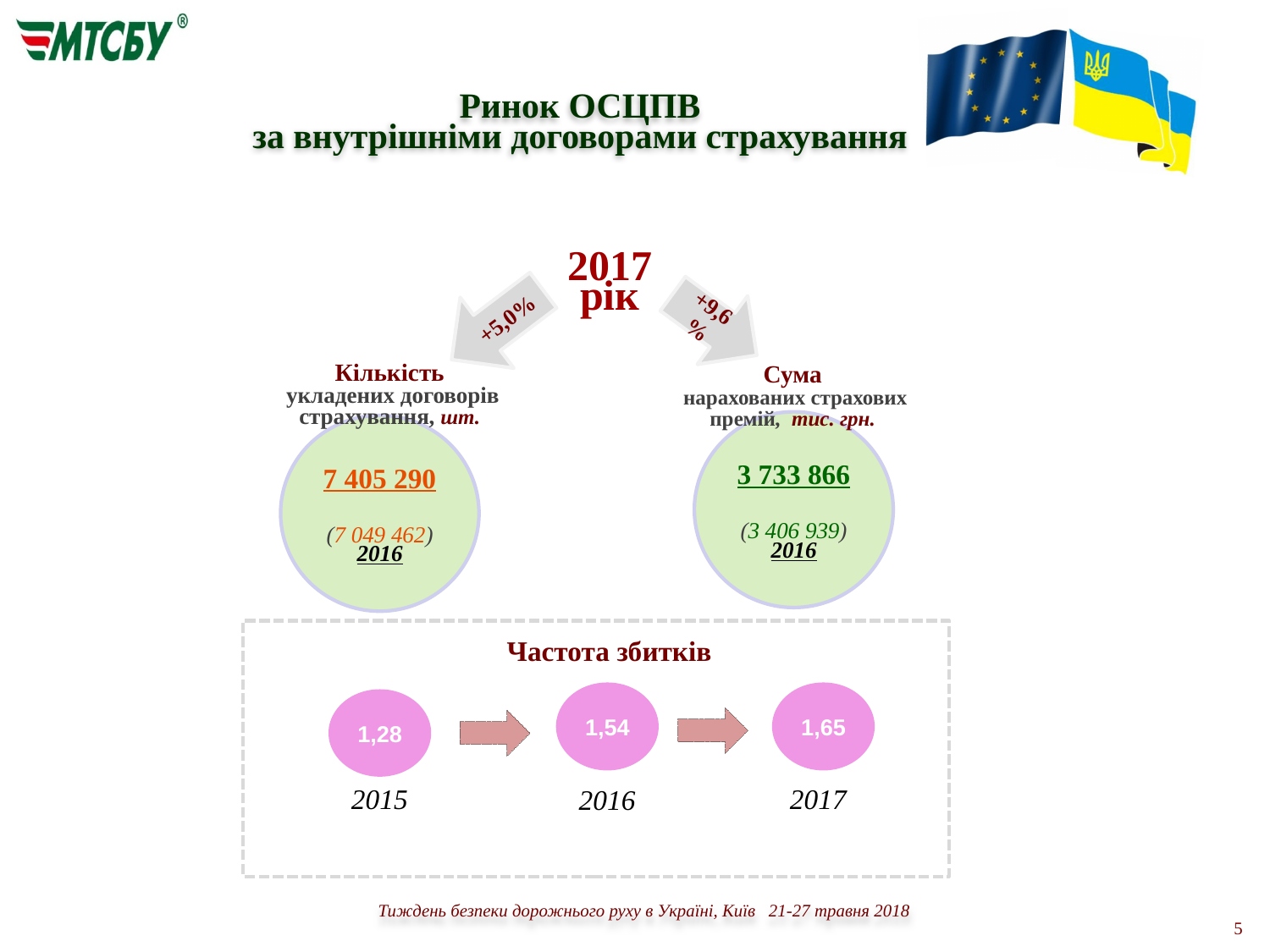
In the 'Частота збитків' section, which year has the highest value? 2017 What is the number of concluded insurance contracts ('Кількість укладених договорів страхування') for 2017? 7 405 290 How many years are shown in the 'Частота збитків' section? 3 What percentage growth is shown for the sum of accrued insurance premiums in 2017? +9,6 % In the 'Частота збитків' section, what is the value shown for 2017? 1,65 What is the difference between the number of concluded insurance contracts in 2017 and in 2016? 355 828 In the 'Частота збитків' section, what is the value shown for 2015? 1,28 In the 'Частота збитків' section, do the values rise or fall from 2015 to 2017? rise In the 'Частота збитків' section, what is the value shown for 2016? 1,54 In the 'Частота збитків' section, which year has the lowest value? 2015 What is the sum of accrued insurance premiums ('Сума нарахованих страхових премій') for 2016? 3 406 939 In the 'Частота збитків' section, what is the difference between the 2017 and 2016 values? 0,11